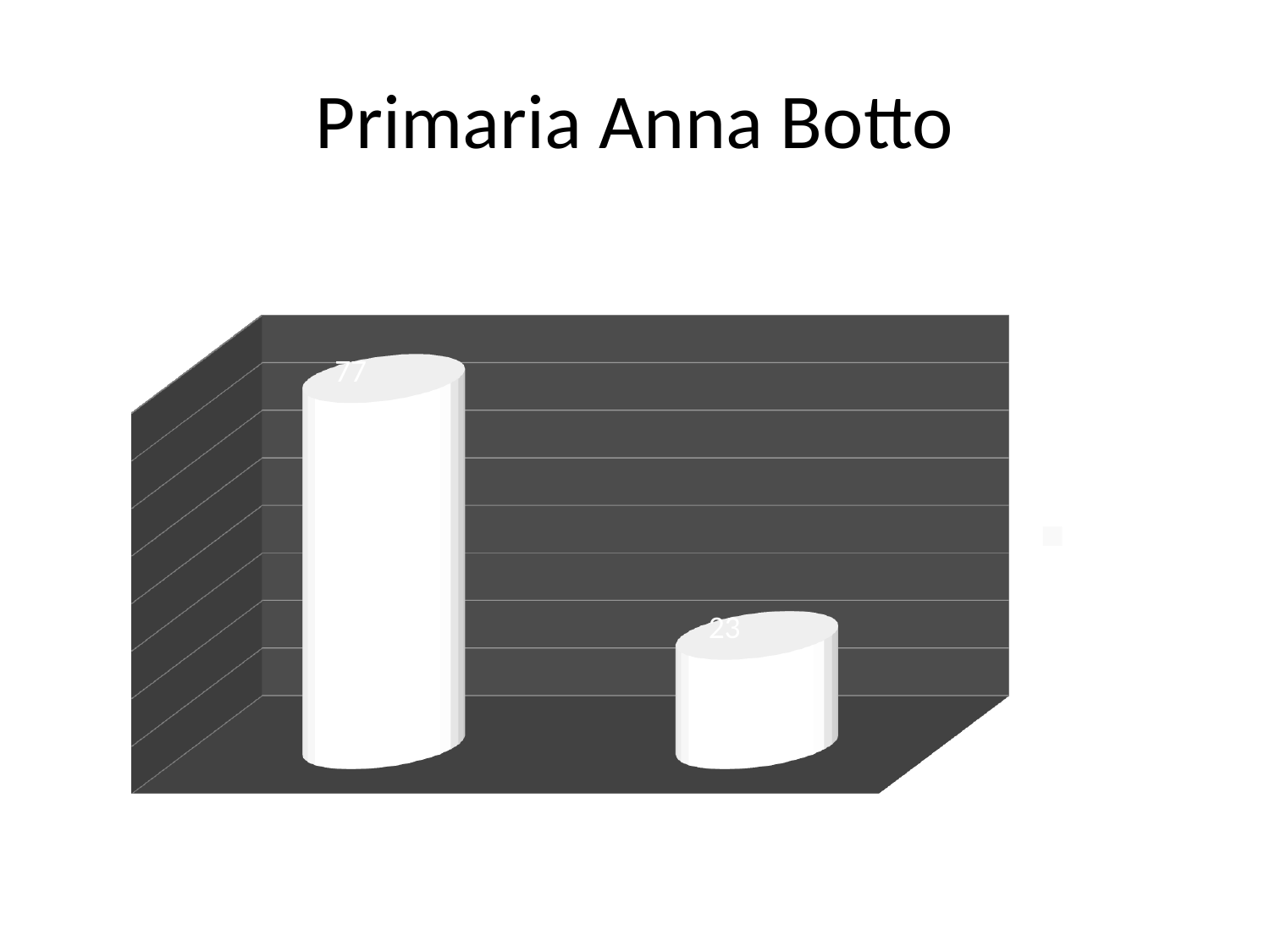
Which bar has the highest value, the left one or the right one? the left one Do the bar values rise or fall from left to right? fall What is the value shown on the right bar of the chart? 23 What colour are the bars in the chart? white How many bars are plotted in the chart? 2 Which bar has the lowest value, the left one or the right one? the right one Is the value of the left bar larger or smaller than the value of the right bar? larger What is the value shown on the left bar of the chart? 77 What is the difference between the value of the left bar and the value of the right bar? 54 What is the title of the slide containing the chart? Primaria Anna Botto What kind of chart is shown on the slide? bar chart